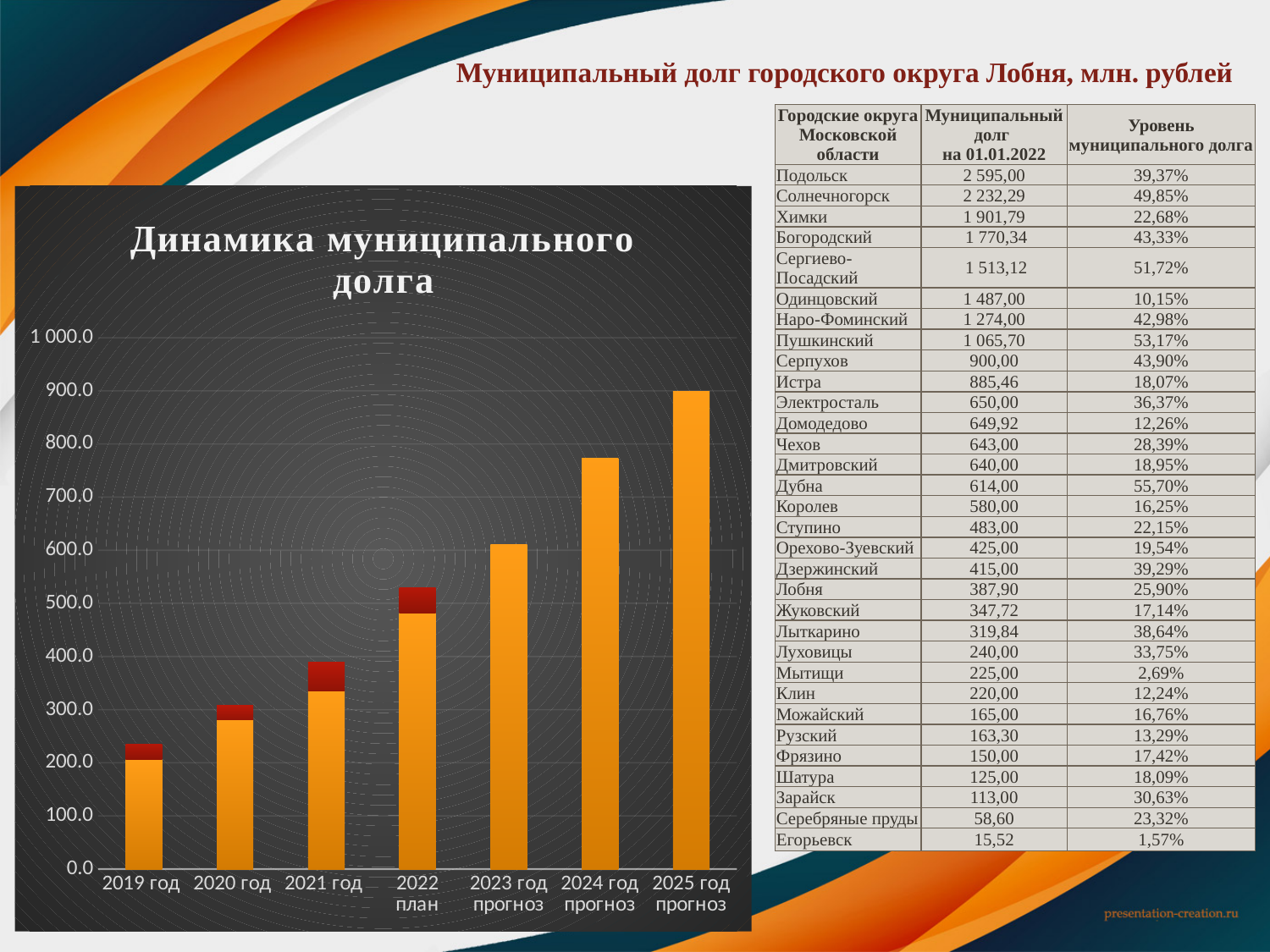
What kind of chart is shown on the slide? bar chart What is the title of the chart on the slide? Динамика муниципального долга Is the bar for 2023 год прогноз greater or less than 700? less What is the label of the last category on the x axis of the chart? 2025 год прогноз Do the bar values rise or fall from 2019 to 2025 in the chart? rise Is the bar for 2025 год прогноз greater or less than 800? greater Which year has the tallest bar in the chart? 2025 год прогноз Which bar is taller, 2022 план or 2020 год? 2022 план Which year has the shortest bar in the chart? 2019 год How many years (categories) are shown on the x axis of the chart? 7 Is the total bar for 2019 год greater or less than 300? less